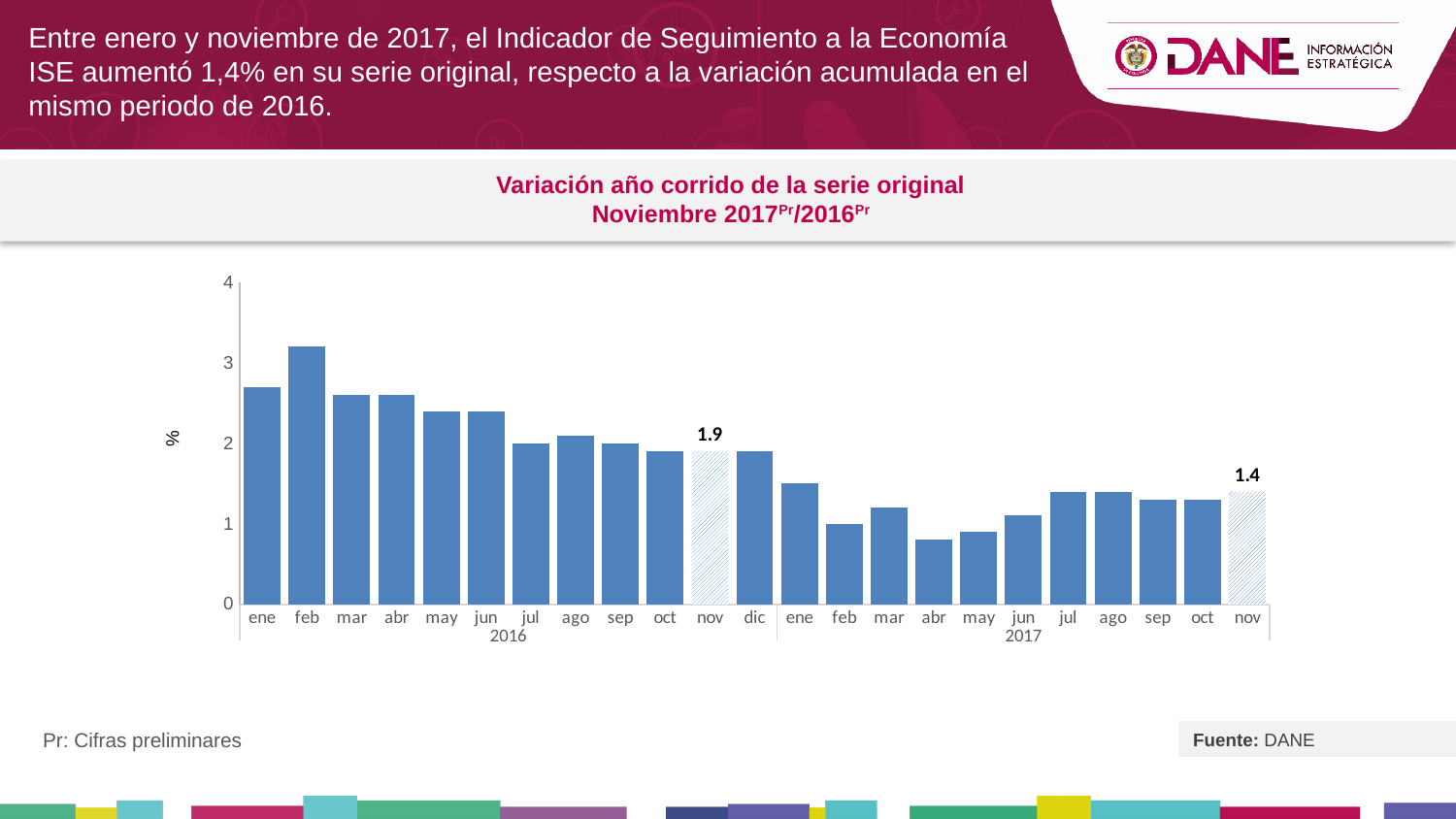
What kind of chart is shown on the slide? bar chart Which month has the highest value in the chart? feb 2016 How many bars are plotted in the chart? 23 Which is larger, the value for nov 2016 or the value for nov 2017? nov 2016 Is the value for abr 2017 greater or less than 1? less Is the value for feb 2016 greater or less than 3? greater Do the values generally rise or fall from feb 2016 to abr 2017? fall What is the value for nov 2016? 1.9 What is the difference between the values for nov 2016 and nov 2017? 0.5 What unit is shown on the y axis of the chart? % Is the value for ene 2016 greater or less than 2? greater What is the value for nov 2017? 1.4